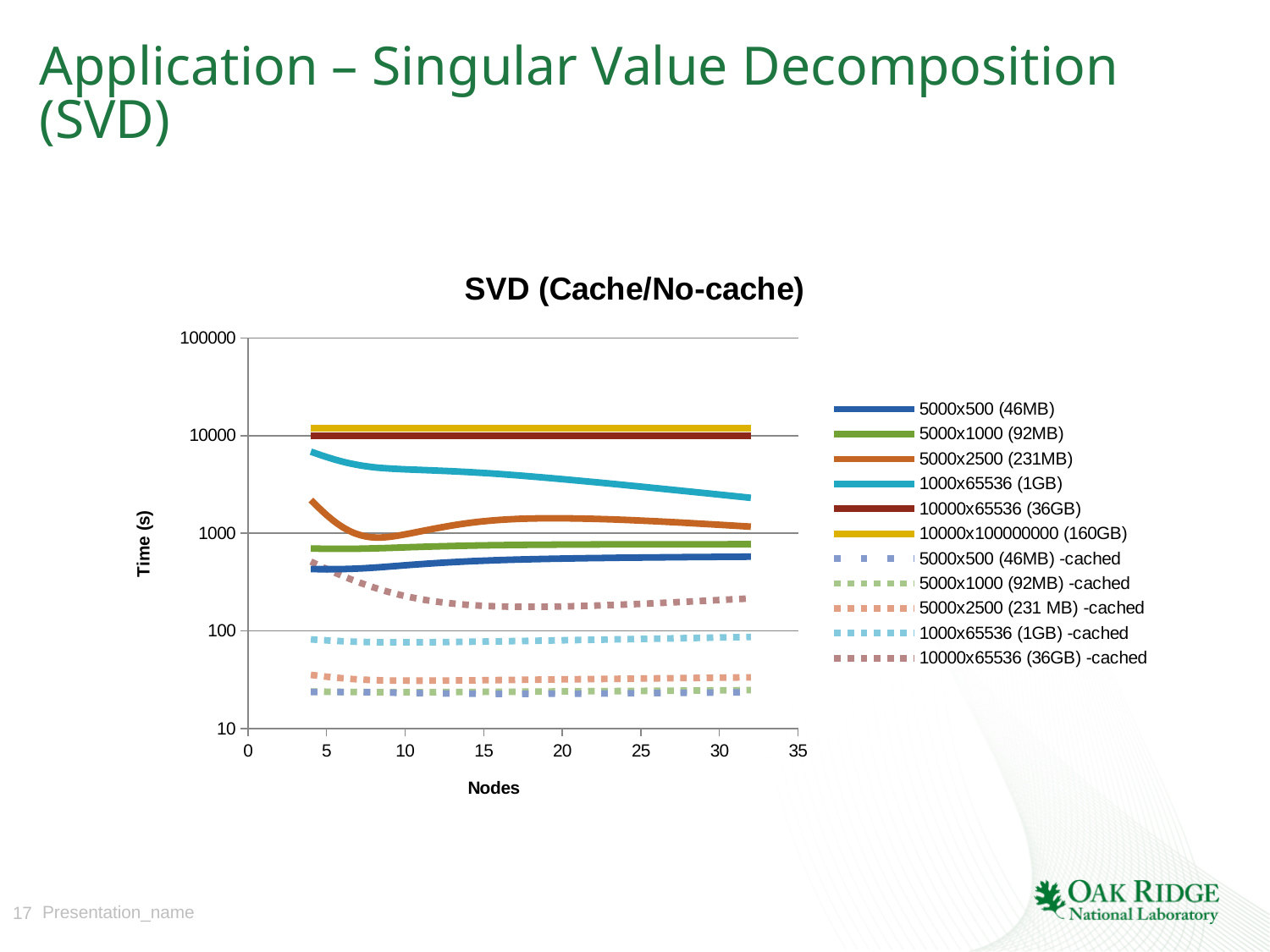
Is the value for 5000x500 (46MB) -cached at 20 nodes greater or less than 100? less What kind of chart is shown on the slide? line chart What is the label of the vertical axis? Time (s) Does the time for 1000x65536 (1GB) rise or fall as the number of nodes increases? fall What is the title of the chart? SVD (Cache/No-cache) Is the value for 1000x65536 (1GB) at 5 nodes greater or less than 10000? less How many series does the legend list? 11 At 30 nodes, which is larger: 5000x2500 (231MB) or 5000x2500 (231 MB) -cached? 5000x2500 (231MB) Is the value for 10000x65536 (36GB) -cached at 20 nodes greater or less than 1000? less Which is larger at 20 nodes: 10000x65536 (36GB) or 10000x65536 (36GB) -cached? 10000x65536 (36GB) Which series has the highest time across all node counts? 10000x100000000 (160GB)